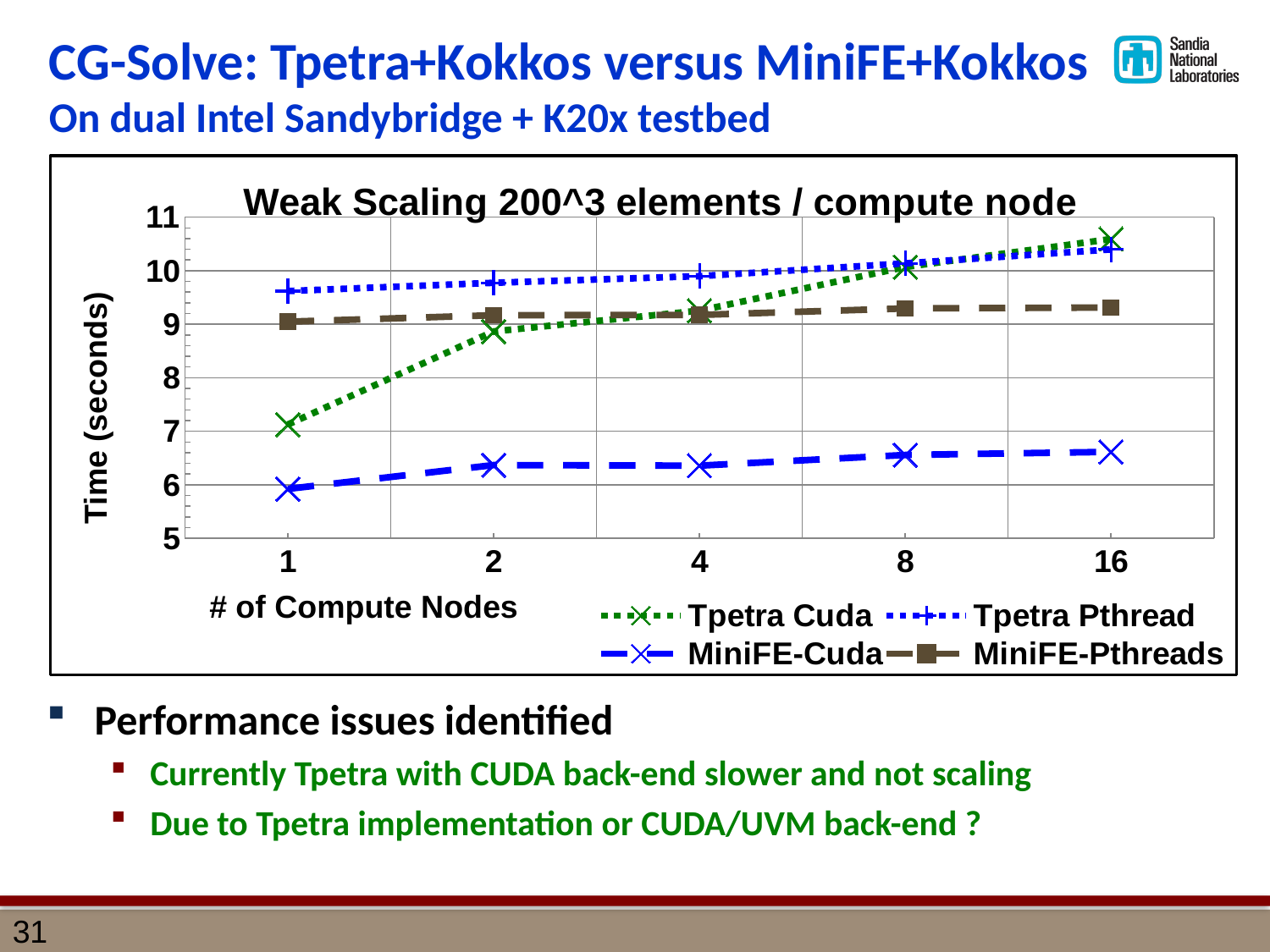
What kind of chart is shown on the slide? line chart Is the value for Tpetra Cuda at 1 compute node greater or less than 8? less Is the value for MiniFE-Cuda at 16 compute nodes greater or less than 7? less Does the time for Tpetra Cuda rise or fall as the number of compute nodes increases? rise What is the label of the y axis? Time (seconds) How many compute-node counts are plotted along the x axis? 5 Which series has the highest time at 1 compute node? Tpetra Pthread Is the value for Tpetra Pthread at 1 compute node greater or less than 9? greater How many series does the legend list? 4 At 16 compute nodes, which is larger: the time for Tpetra Cuda or the time for MiniFE-Pthreads? Tpetra Cuda Which series has the lowest time at 1 compute node? MiniFE-Cuda What is the title of the chart? Weak Scaling 200^3 elements / compute node